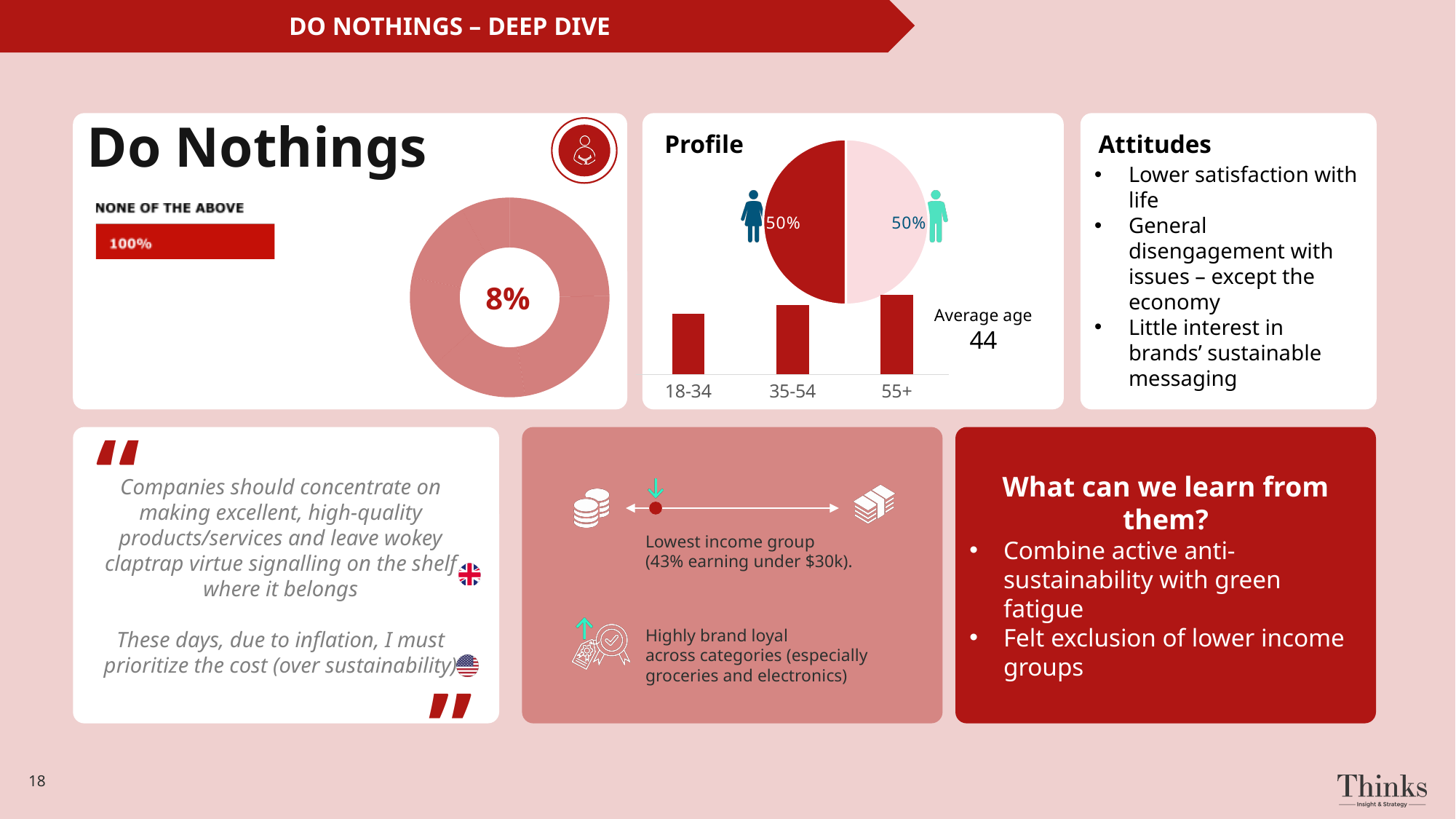
In the Do Nothings donut chart, what percentage is shown in the centre? 8% In the Profile age bar chart, how many age groups are shown? 3 In the Profile age bar chart, which age group has the tallest bar? 55+ How many slices does the Profile pie chart have? 2 In the Profile age bar chart, do the bars rise or fall from 18-34 to 55+? Rise What kind of chart is the chart in the Do Nothings panel showing 8%? Donut chart In the Profile age bar chart, which age group has the shortest bar? 18-34 In the Do Nothings panel, what value is shown on the 'NONE OF THE ABOVE' bar? 100% In the Profile age bar chart, is the bar for 35-54 taller or shorter than the bar for 18-34? Taller In the Profile pie chart, what share is shown for the female segment? 50% In the Profile pie chart, what share is shown for the male segment? 50% What kind of chart is the gender split chart in the Profile panel? Pie chart